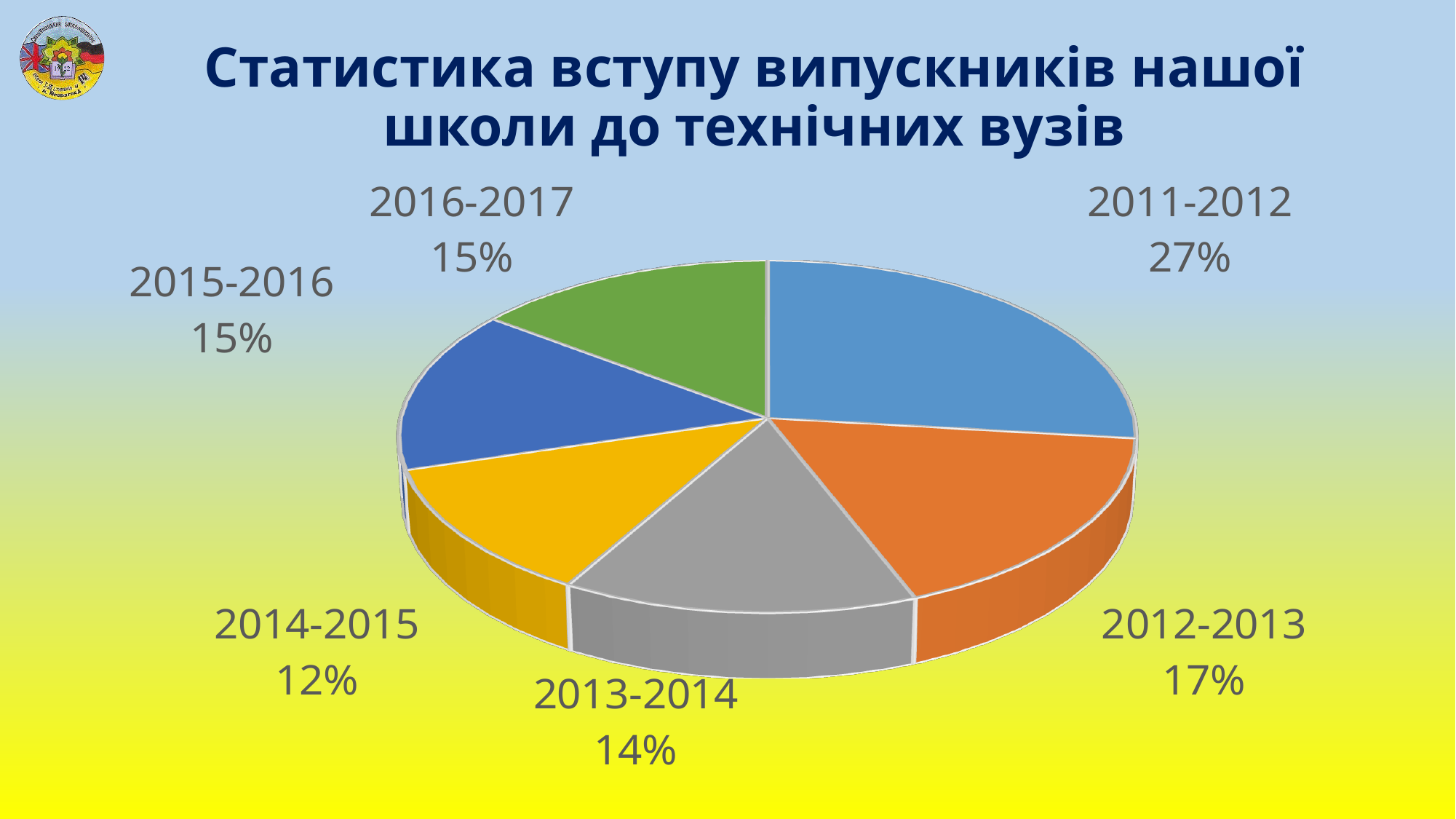
What colour is the slice for 2013-2014? Grey Which is larger, the share for 2012-2013 or the share for 2013-2014? 2012-2013 What share of the pie does 2011-2012 have? 27% What is the value shown for 2013-2014? 14% How many slices does the pie chart have? 6 What is the value shown for 2014-2015? 12% What is the title of the chart on the slide? Статистика вступу випускників нашої школи до технічних вузів Which year has the smallest slice of the pie? 2014-2015 What is the difference between the shares for 2011-2012 and 2012-2013? 10% What is the difference between the shares for 2016-2017 and 2014-2015? 3% What kind of chart is shown on the slide? Pie chart Which year has the largest slice of the pie? 2011-2012